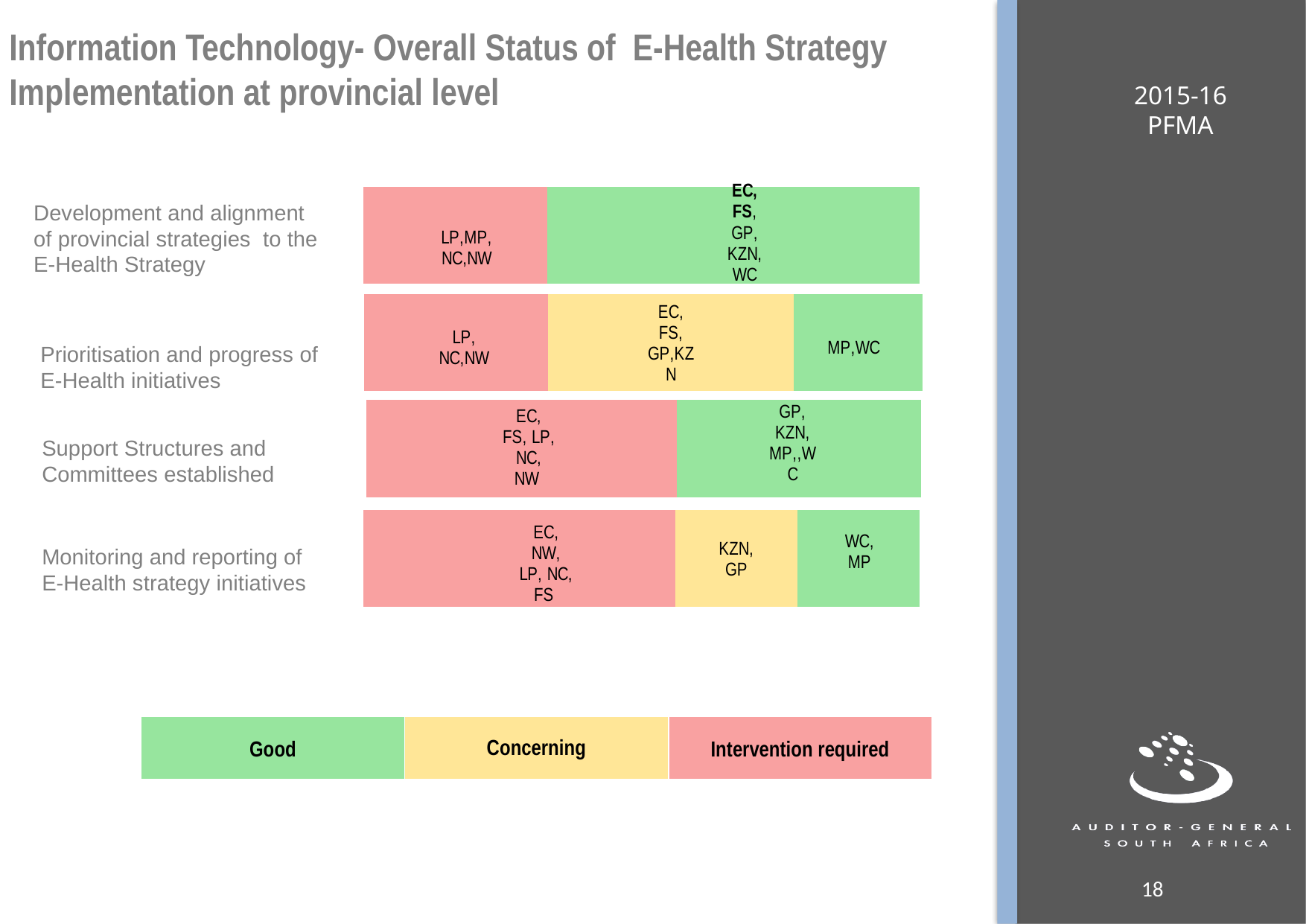
Which provinces are rated 'Concerning' for 'Monitoring and reporting of E-Health strategy initiatives'? KZN, GP Which status is shown in yellow in the legend? Concerning What kind of chart is shown on the slide? Bar chart How many categories (rows) does the chart show? 4 How many status levels does the legend list? 3 Which provinces are rated 'Good' for 'Support Structures and Committees established'? GP, KZN, MP, WC Which provinces are in the 'Intervention required' segment for 'Prioritisation and progress of E-Health initiatives'? LP, NC, NW For 'Support Structures and Committees established', which status has more provinces: 'Intervention required' or 'Good'? Intervention required How many provinces are rated 'Good' for 'Monitoring and reporting of E-Health strategy initiatives'? 2 Which provinces are rated 'Good' for 'Development and alignment of provincial strategies to the E-Health Strategy'? EC, FS, GP, KZN, WC Which colour represents 'Intervention required' in the legend? Red